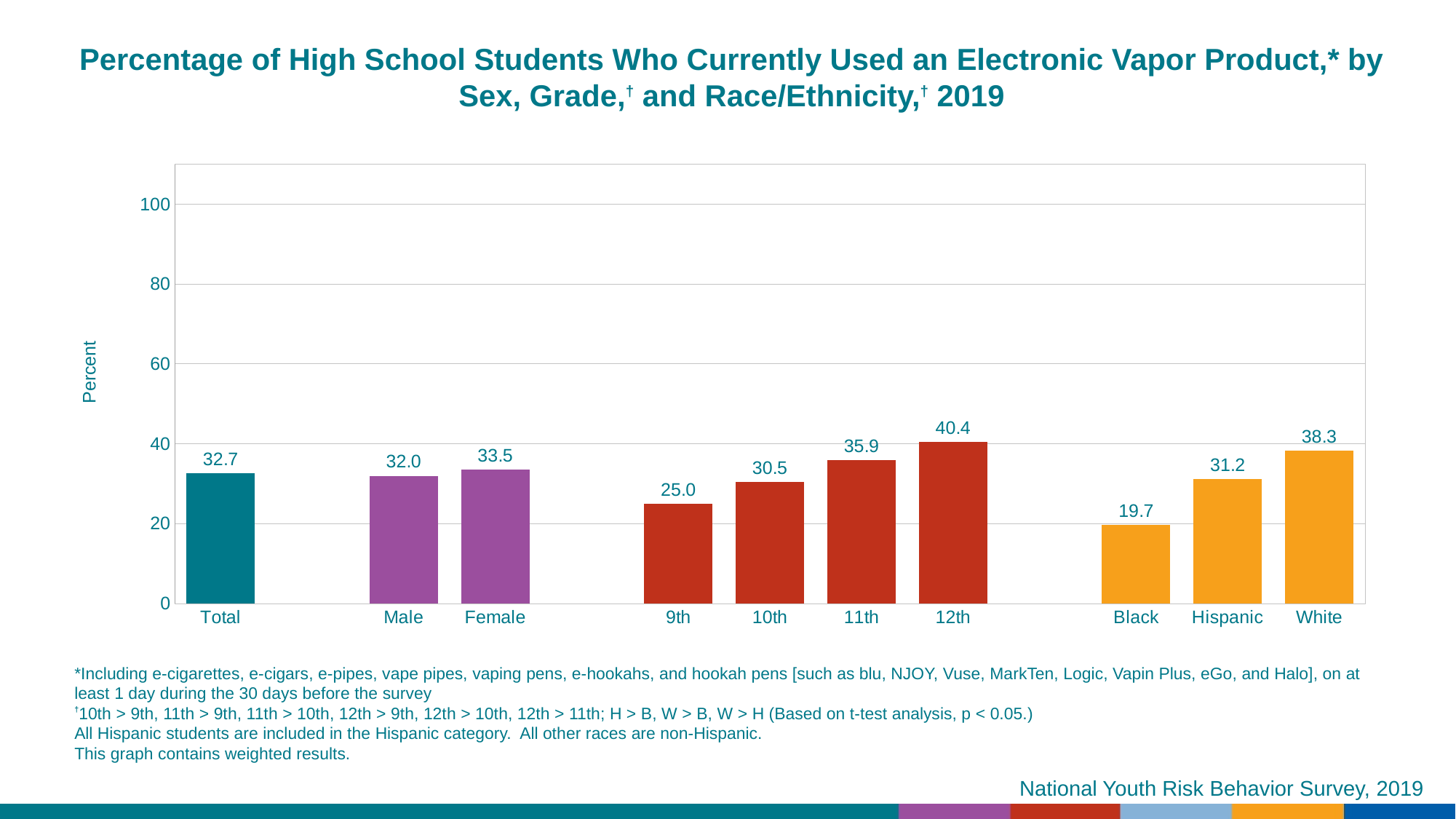
What is the value for Total? 32.7 How many categories are shown on the x axis? 10 Which category has the lowest value? Black What kind of chart is this? bar chart Do the values rise or fall from 9th grade to 12th grade? rise What is the value for Black students? 19.7 What is the difference between the values for Female and Male? 1.5 What is the difference between the values for White and Hispanic? 7.1 What is the value for 12th grade? 40.4 Which category has the highest value? 12th Is the value for 9th grade greater or less than 40? less Which is larger, the value for 11th grade or the value for 10th grade? 11th